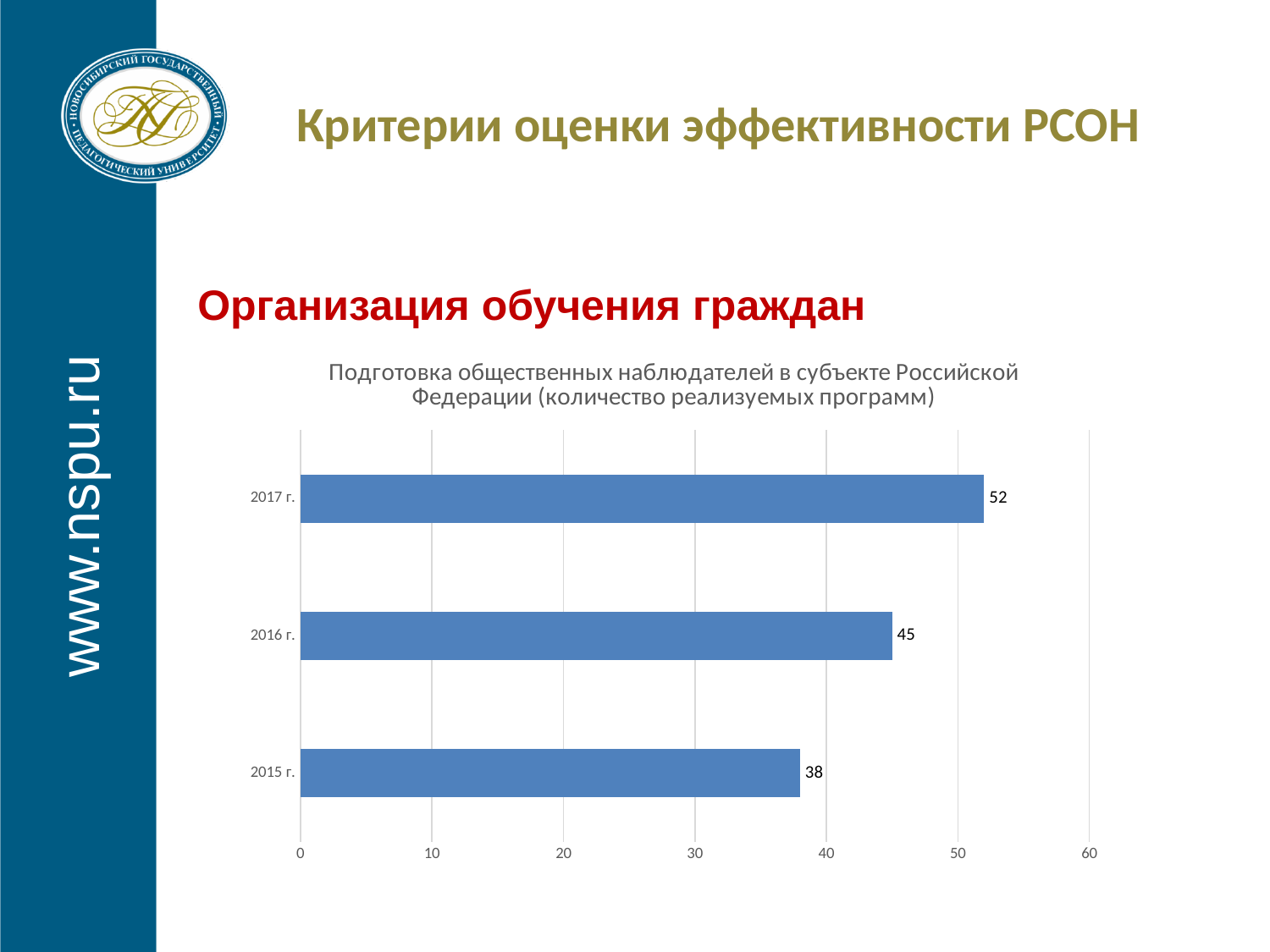
Which year has the lowest value? 2015 г. What is the difference between the values for 2017 г. and 2015 г.? 14 Is the value for 2017 г. greater or less than 50? greater Do the values rise or fall from 2015 г. to 2017 г.? rise What is the value for 2017 г.? 52 Which is larger, the value for 2016 г. or the value for 2015 г.? 2016 г. How many years are shown in the chart? 3 What is the difference between the values for 2016 г. and 2015 г.? 7 What kind of chart is shown on the slide? bar chart What is the value for 2015 г.? 38 What is the value for 2016 г.? 45 Which year has the highest value? 2017 г.